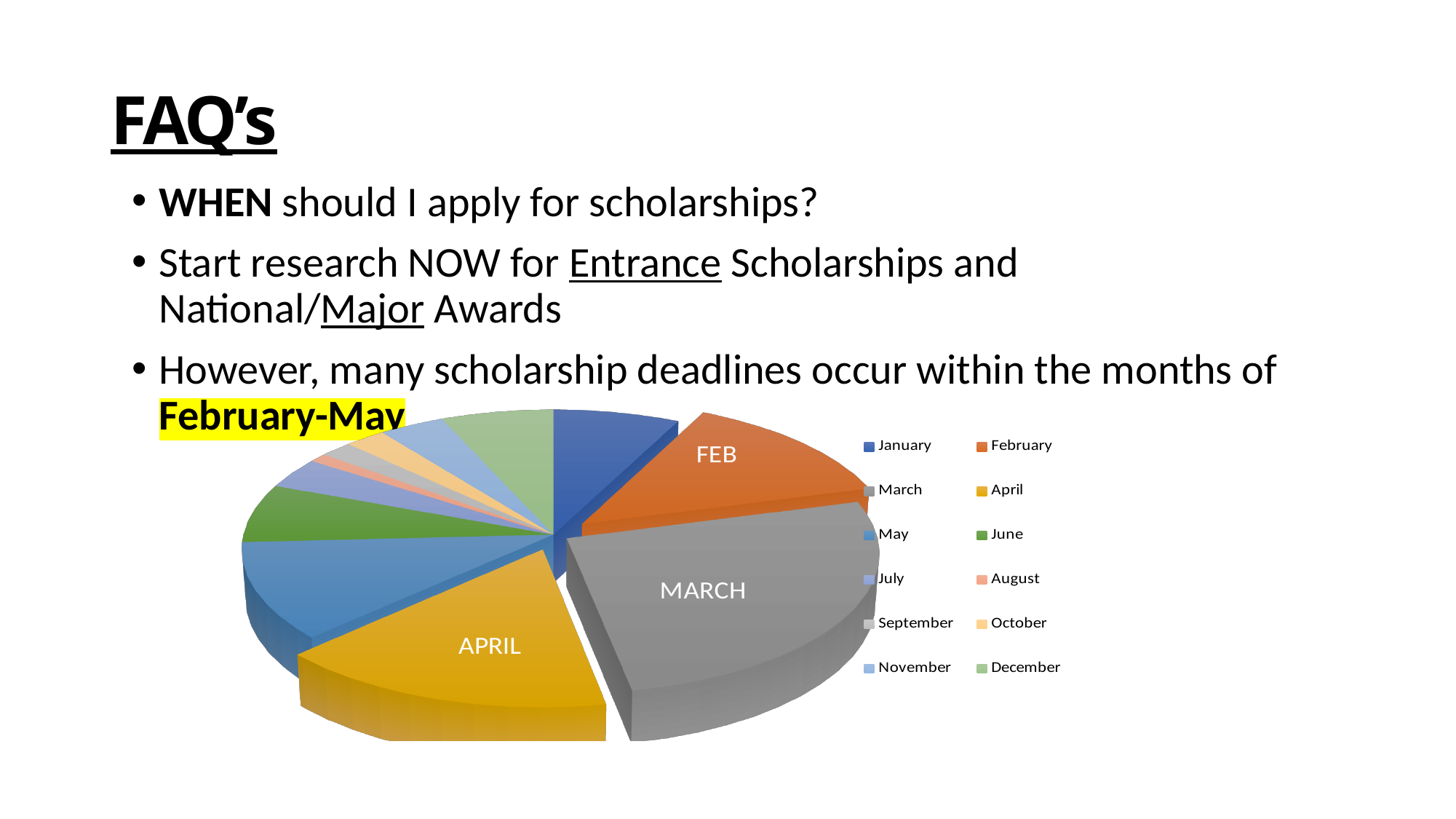
Which slice is larger in the pie chart, April or February? April Which slice is larger in the pie chart, March or December? March Which slice is larger in the pie chart, February or August? February Which month has the largest slice in the pie chart? March What kind of chart is shown on the slide? pie chart Which three slices of the pie chart carry text labels directly on them? FEB, MARCH, APRIL How many categories (months) does the pie chart's legend list? 12 What colour is the March slice in the pie chart? gray